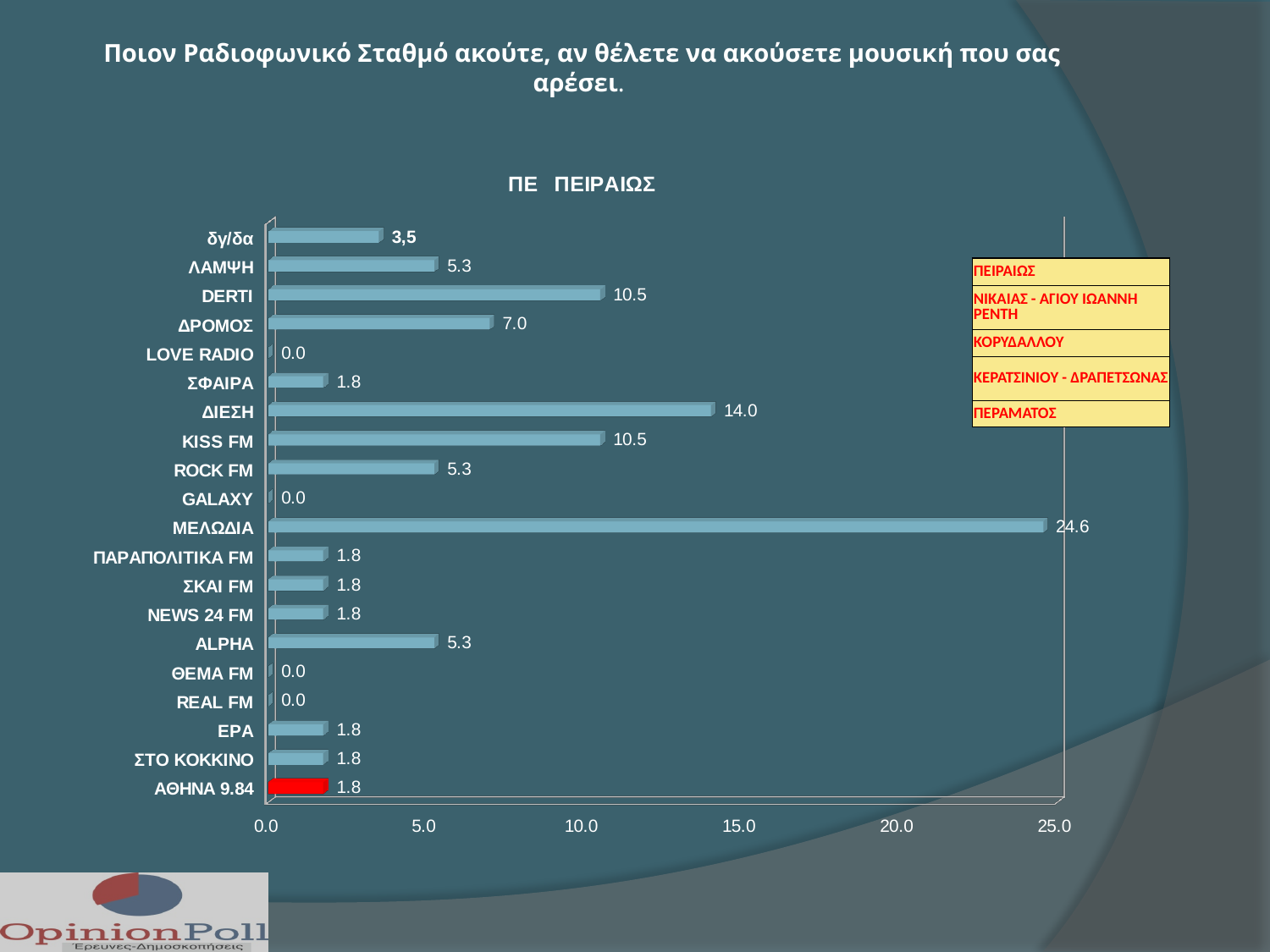
What is the value for ΔΡΟΜΟΣ in the ΠΕ ΠΕΙΡΑΙΩΣ chart? 7.0 Is the value for ΜΕΛΩΔΙΑ in the ΠΕ ΠΕΙΡΑΙΩΣ chart greater or less than 20.0? greater What is the value for δγ/δα in the ΠΕ ΠΕΙΡΑΙΩΣ chart? 3,5 What kind of chart is shown on the slide? bar chart What is the difference between the values for ΜΕΛΩΔΙΑ and ΔΙΕΣΗ in the ΠΕ ΠΕΙΡΑΙΩΣ chart? 10.6 Which has a larger value in the ΠΕ ΠΕΙΡΑΙΩΣ chart, ΔΡΟΜΟΣ or ΛΑΜΨΗ? ΔΡΟΜΟΣ Which category's bar is coloured red in the ΠΕ ΠΕΙΡΑΙΩΣ chart? ΑΘΗΝΑ 9.84 What is the value for ΔΙΕΣΗ in the ΠΕ ΠΕΙΡΑΙΩΣ chart? 14.0 What is the value for ΜΕΛΩΔΙΑ in the ΠΕ ΠΕΙΡΑΙΩΣ chart? 24.6 How many radio station categories are shown in the ΠΕ ΠΕΙΡΑΙΩΣ chart? 20 What is the difference between the values for DERTI and ΔΡΟΜΟΣ in the ΠΕ ΠΕΙΡΑΙΩΣ chart? 3.5 Which radio station has the highest value in the ΠΕ ΠΕΙΡΑΙΩΣ chart? ΜΕΛΩΔΙΑ